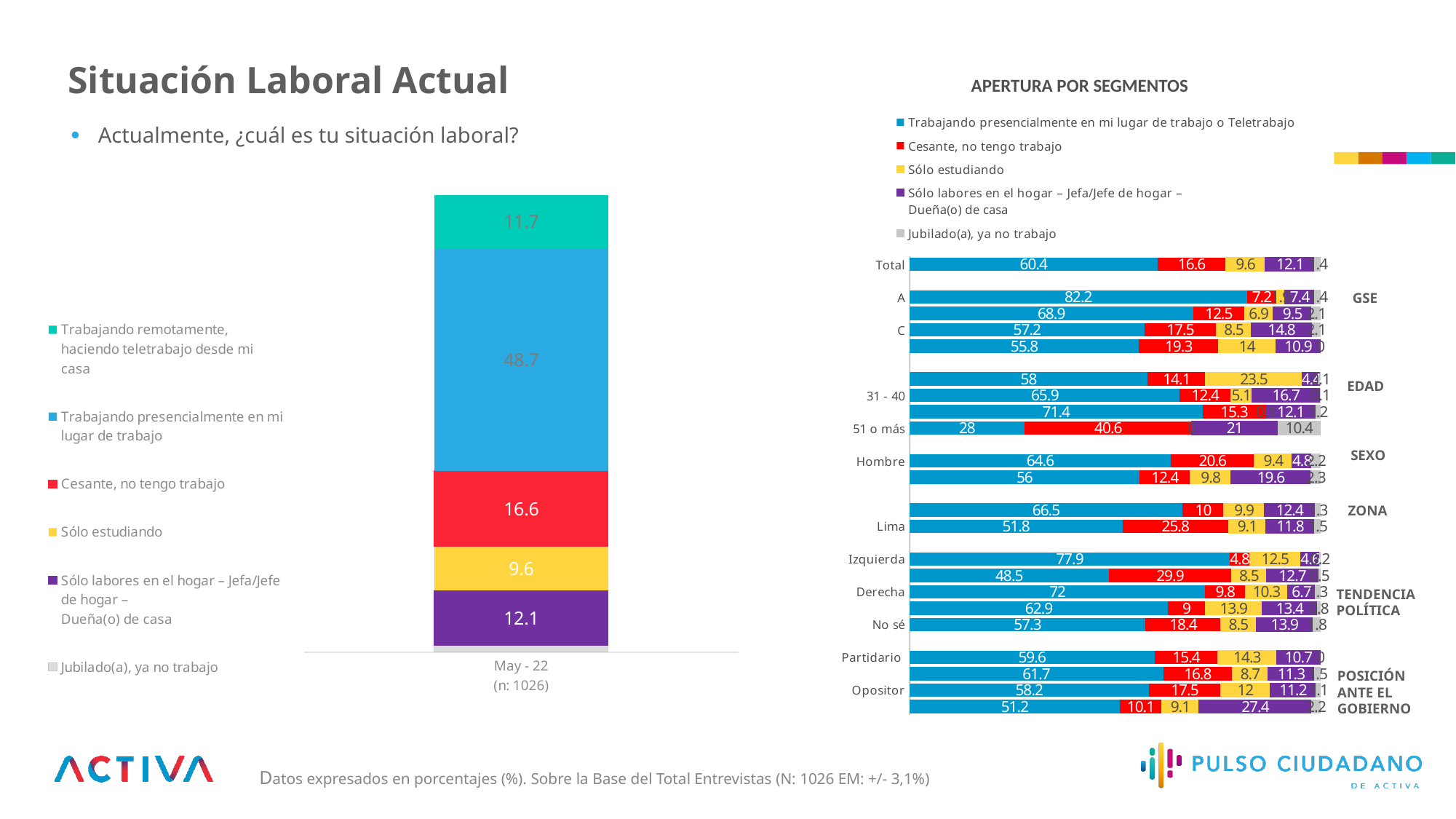
In the right chart (APERTURA POR SEGMENTOS), what is the value of "Cesante, no tengo trabajo" for "Lima"? 25.8 In the left chart (Situación Laboral Actual), what is the value for "Trabajando presencialmente en mi lugar de trabajo"? 48.7 In the right chart (APERTURA POR SEGMENTOS), which has the larger "Cesante, no tengo trabajo" value: "Lima" or "Hombre"? Lima In the right chart (APERTURA POR SEGMENTOS), what is the value of "Cesante, no tengo trabajo" for the "51 o más" segment? 40.6 How many entries does the legend of the left chart (Situación Laboral Actual) list? 6 In the right chart (APERTURA POR SEGMENTOS), what is the value of "Trabajando presencialmente en mi lugar de trabajo o Teletrabajo" for the "Izquierda" segment? 77.9 In the left chart (Situación Laboral Actual), what is the value for "Cesante, no tengo trabajo"? 16.6 In the left chart (Situación Laboral Actual), what is the difference between "Trabajando presencialmente en mi lugar de trabajo" and "Trabajando remotamente, haciendo teletrabajo desde mi casa"? 37 What kind of chart is the left chart (Situación Laboral Actual)? Stacked bar chart In the left chart (Situación Laboral Actual), which labelled segment has the largest value? Trabajando presencialmente en mi lugar de trabajo In the right chart (APERTURA POR SEGMENTOS), what is the difference between the "Trabajando presencialmente en mi lugar de trabajo o Teletrabajo" value for "Hombre" and for "Total"? 4.2 In the right chart (APERTURA POR SEGMENTOS), what is the value of "Sólo estudiando" for the "Partidario" segment? 14.3